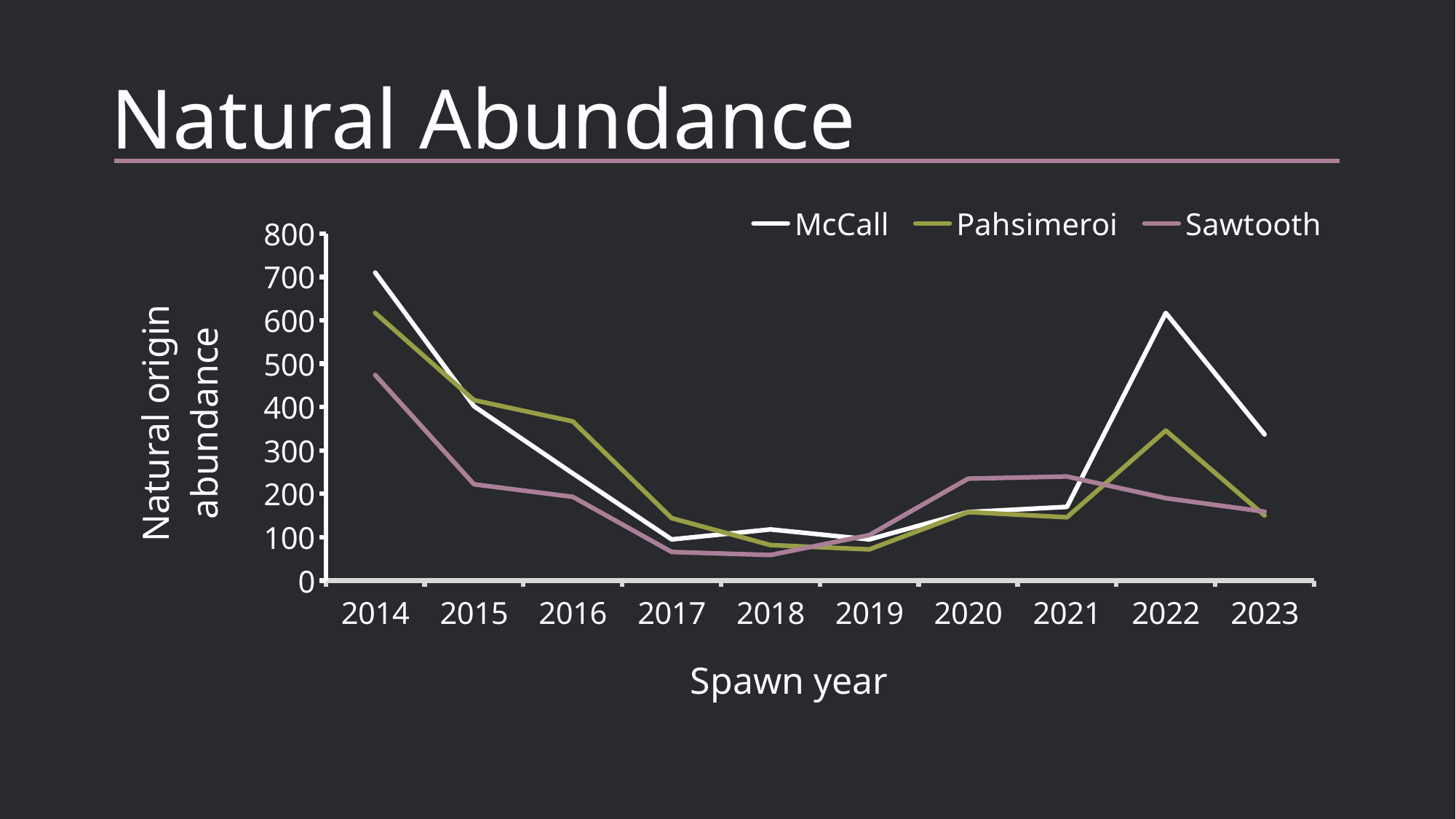
Is the Sawtooth value for 2014 greater or less than 400? greater Is the Pahsimeroi value for 2022 greater or less than 300? greater Is the Sawtooth value for 2017 greater or less than 100? less Does the McCall series rise or fall from 2014 to 2017? fall What kind of chart is shown on the slide? line chart How many series does the legend list? 3 In 2021, which series has the larger value, Sawtooth or Pahsimeroi? Sawtooth In which spawn year is the McCall series at its highest? 2014 In 2022, which series has the larger value, McCall or Pahsimeroi? McCall In which spawn year is the Sawtooth series at its highest? 2014 How many spawn years are plotted along the x axis? 10